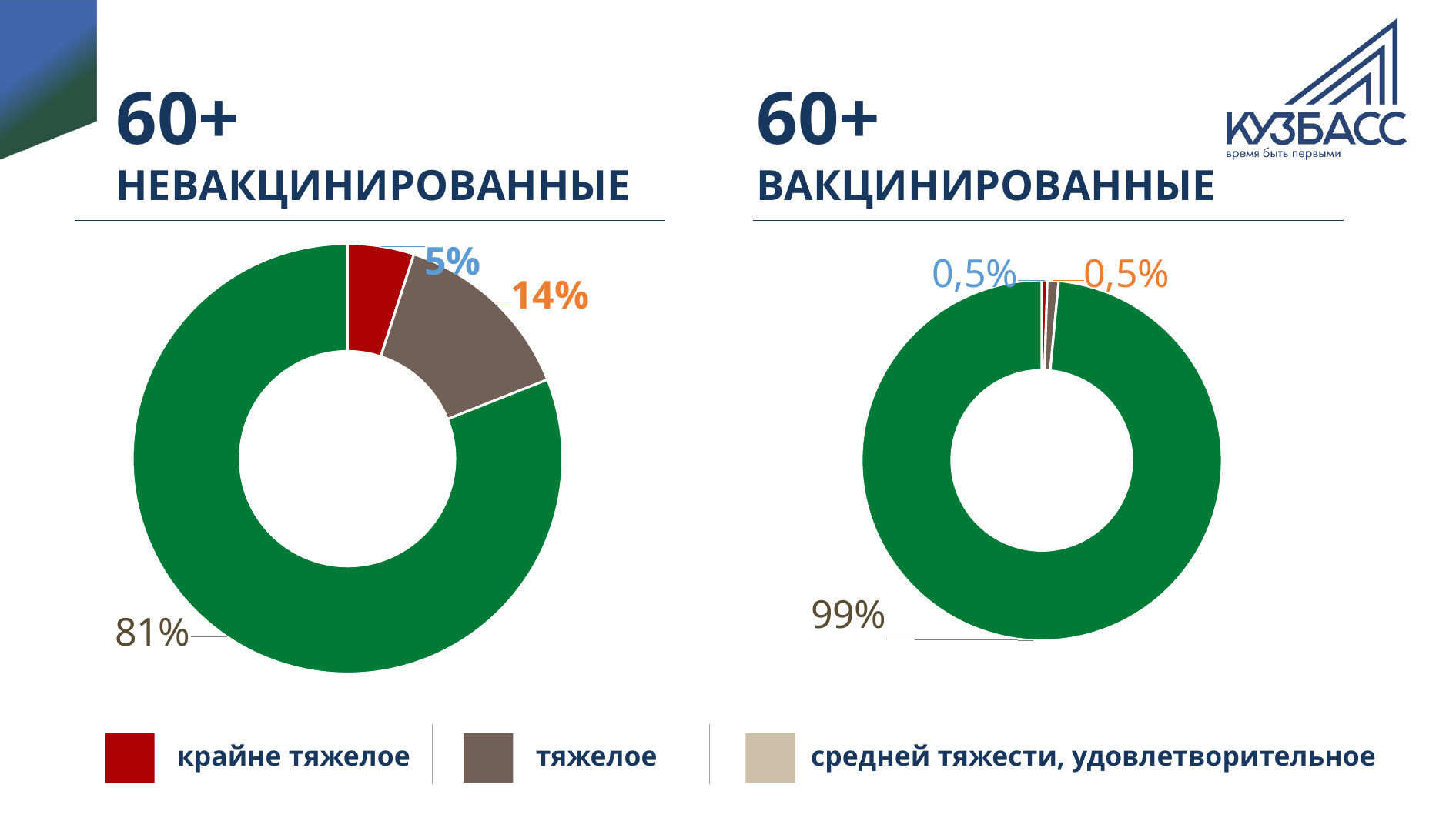
In the "60+ НЕВАКЦИНИРОВАННЫЕ" chart, what share is labelled for the red slice (крайне тяжелое)? 5% In the "60+ НЕВАКЦИНИРОВАННЫЕ" chart, what is the value of the smallest slice? 5% Which chart shows the larger share for тяжелое: "60+ НЕВАКЦИНИРОВАННЫЕ" or "60+ ВАКЦИНИРОВАННЫЕ"? 60+ НЕВАКЦИНИРОВАННЫЕ In the "60+ ВАКЦИНИРОВАННЫЕ" chart, what share is labelled for the brown slice (тяжелое)? 0,5% In the "60+ НЕВАКЦИНИРОВАННЫЕ" chart, by how many percentage points does тяжелое (14%) exceed крайне тяжелое (5%)? 9 percentage points In the "60+ НЕВАКЦИНИРОВАННЫЕ" chart, what is the value of the largest slice? 81% In the "60+ ВАКЦИНИРОВАННЫЕ" chart, what is the value of the largest slice? 99% How many slices does the "60+ НЕВАКЦИНИРОВАННЫЕ" chart have? 3 In the "60+ НЕВАКЦИНИРОВАННЫЕ" chart, what share is labelled for the brown slice (тяжелое)? 14% How many entries does the legend at the bottom of the slide list? 3 What kind of chart is shown under the title "60+ НЕВАКЦИНИРОВАННЫЕ"? Pie (donut) chart In the "60+ ВАКЦИНИРОВАННЫЕ" chart, what share is labelled for the red slice (крайне тяжелое)? 0,5%